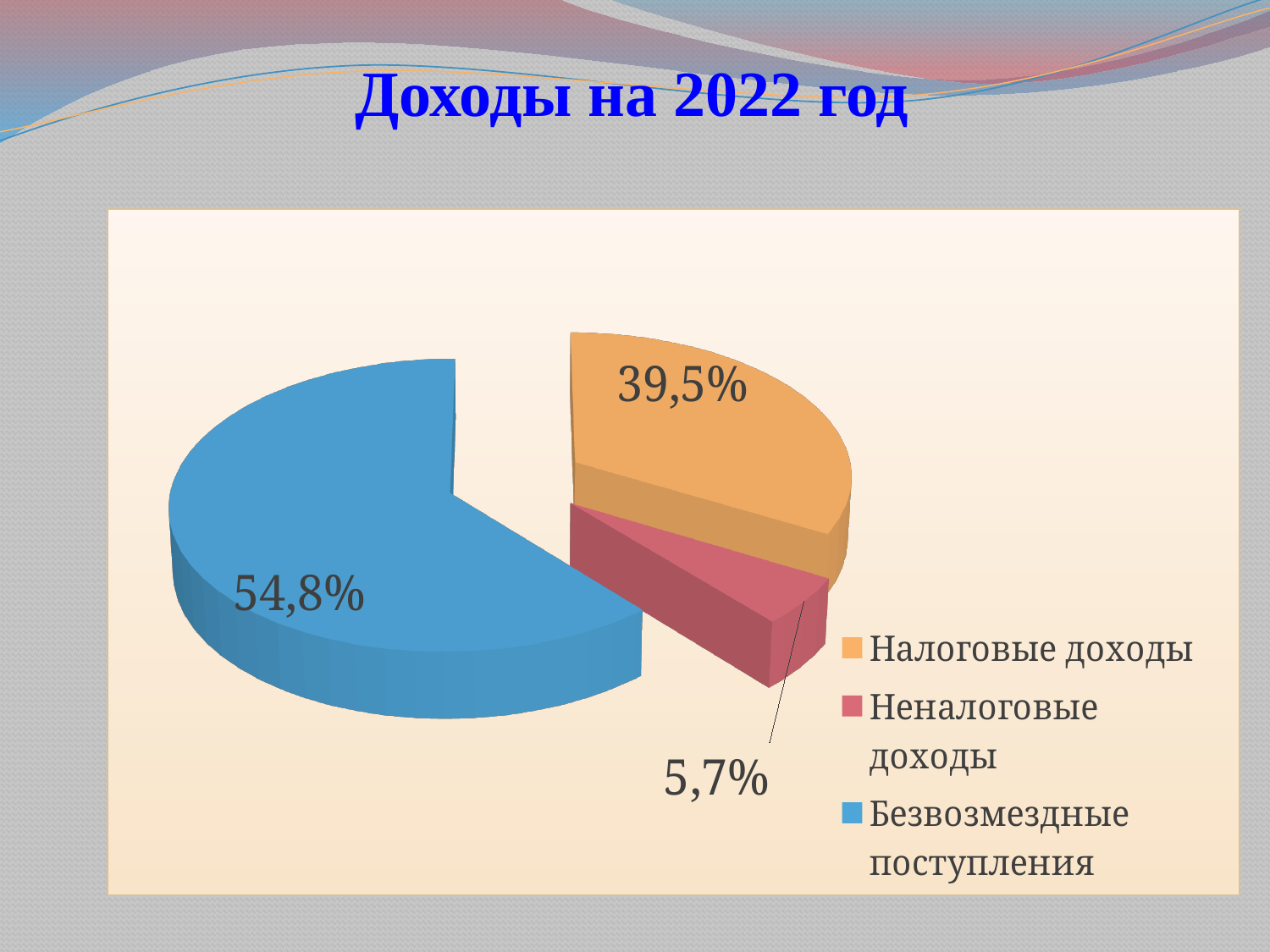
What is the title of the slide? Доходы на 2022 год What is the difference between the shares of Налоговые доходы and Неналоговые доходы? 33,8% What is the difference between the shares of Безвозмездные поступления and Налоговые доходы? 15,3% What is the share for Безвозмездные поступления? 54,8% Which category has the smallest share of the pie? Неналоговые доходы What kind of chart is shown on the slide? pie chart How many entries does the legend list? 3 Which category has the largest share of the pie? Безвозмездные поступления How many slices does the pie chart have? 3 What is the share for Налоговые доходы? 39,5% Which is larger, the share of Налоговые доходы or the share of Неналоговые доходы? Налоговые доходы What is the share for Неналоговые доходы? 5,7%